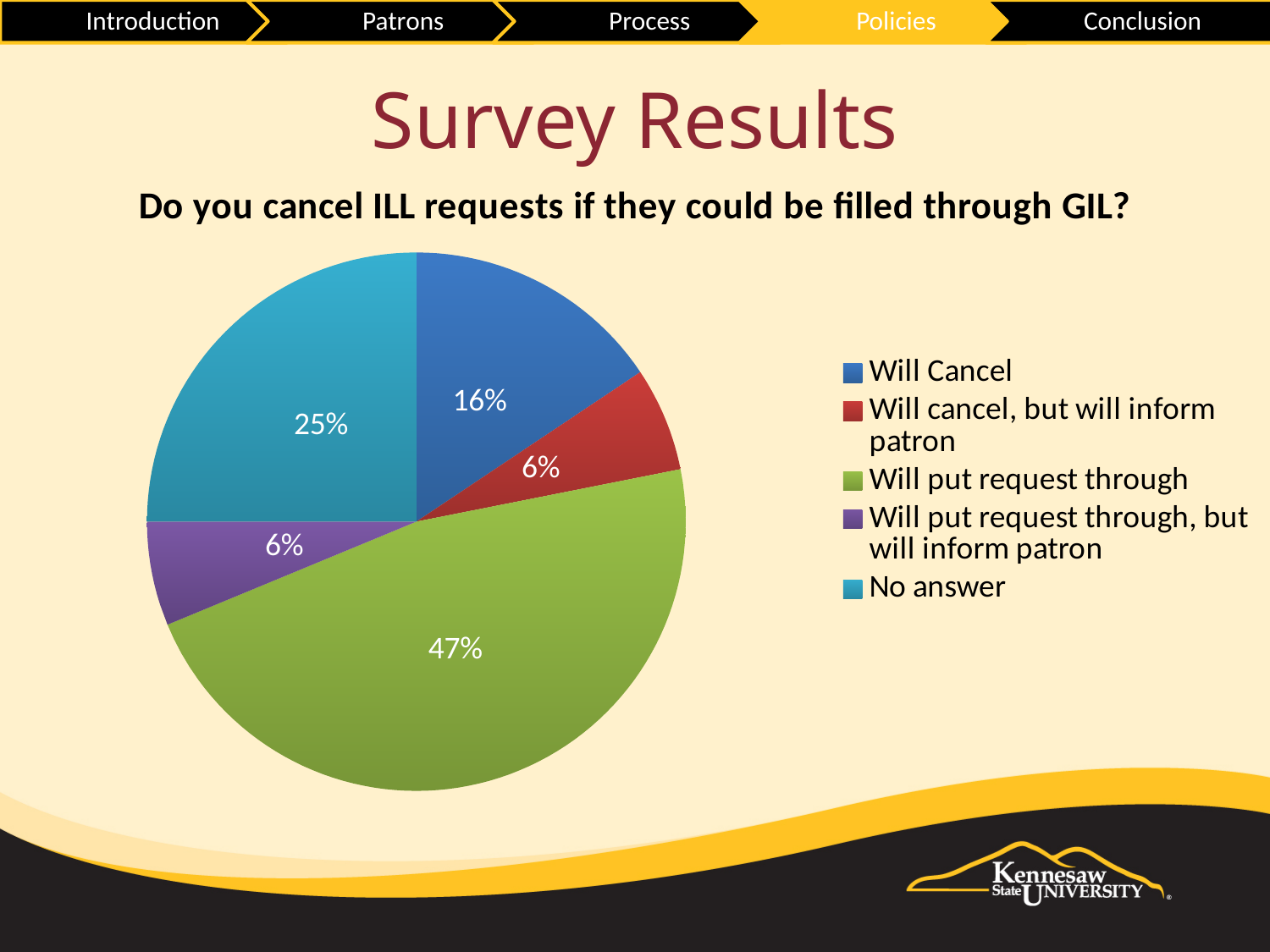
Which is larger, the share for 'No answer' or the share for 'Will Cancel'? No answer What share of the pie is 'Will put request through'? 47% What share of the pie is 'Will cancel, but will inform patron'? 6% What is the difference between the shares for 'Will put request through' and 'No answer'? 22% How many slices does the pie chart have? 5 What is the difference between the shares for 'Will Cancel' and 'Will put request through, but will inform patron'? 10% What share of the pie is 'No answer'? 25% Which category has the largest slice of the pie? Will put request through What kind of chart is shown on the slide? pie chart How many entries does the legend list? 5 What question does the chart title ask? Do you cancel ILL requests if they could be filled through GIL?